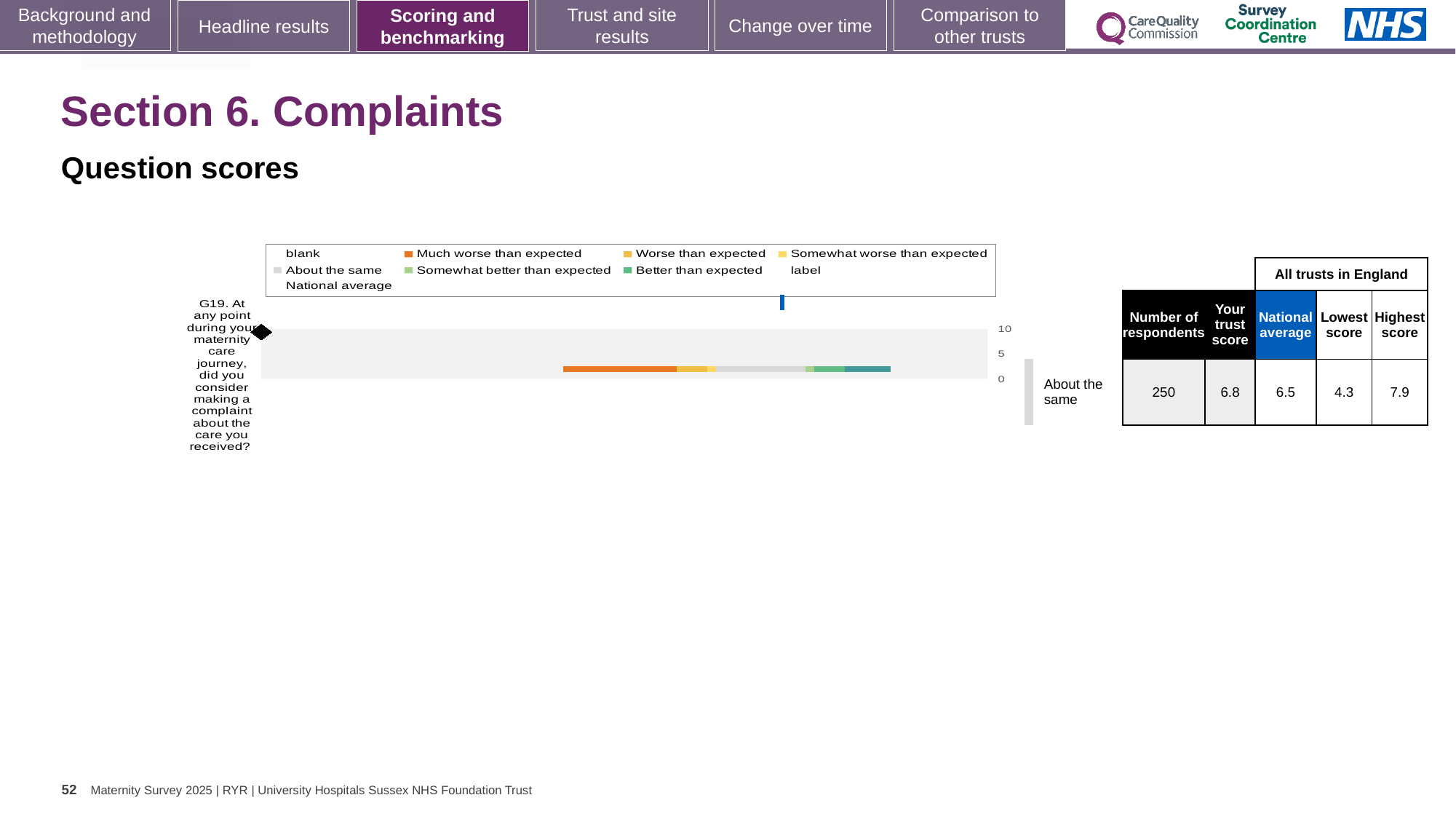
Which is larger for question G19: the trust score or the national average? the trust score What is the lowest score among all trusts in England for question G19? 4.3 What colour does the legend use for 'Much worse than expected'? orange Which benchmark category is question G19 placed in, according to the label next to the chart? About the same What is the highest score among all trusts in England for question G19? 7.9 What kind of chart is shown on the slide for question G19? bar chart By how much does the trust score exceed the national average for question G19? 0.3 How many survey questions are plotted in the chart? 1 How many respondents answered question G19? 250 What is the difference between the highest score and the lowest score for question G19? 3.6 What is the national average score for question G19? 6.5 What is the trust score for question G19 shown alongside the chart? 6.8